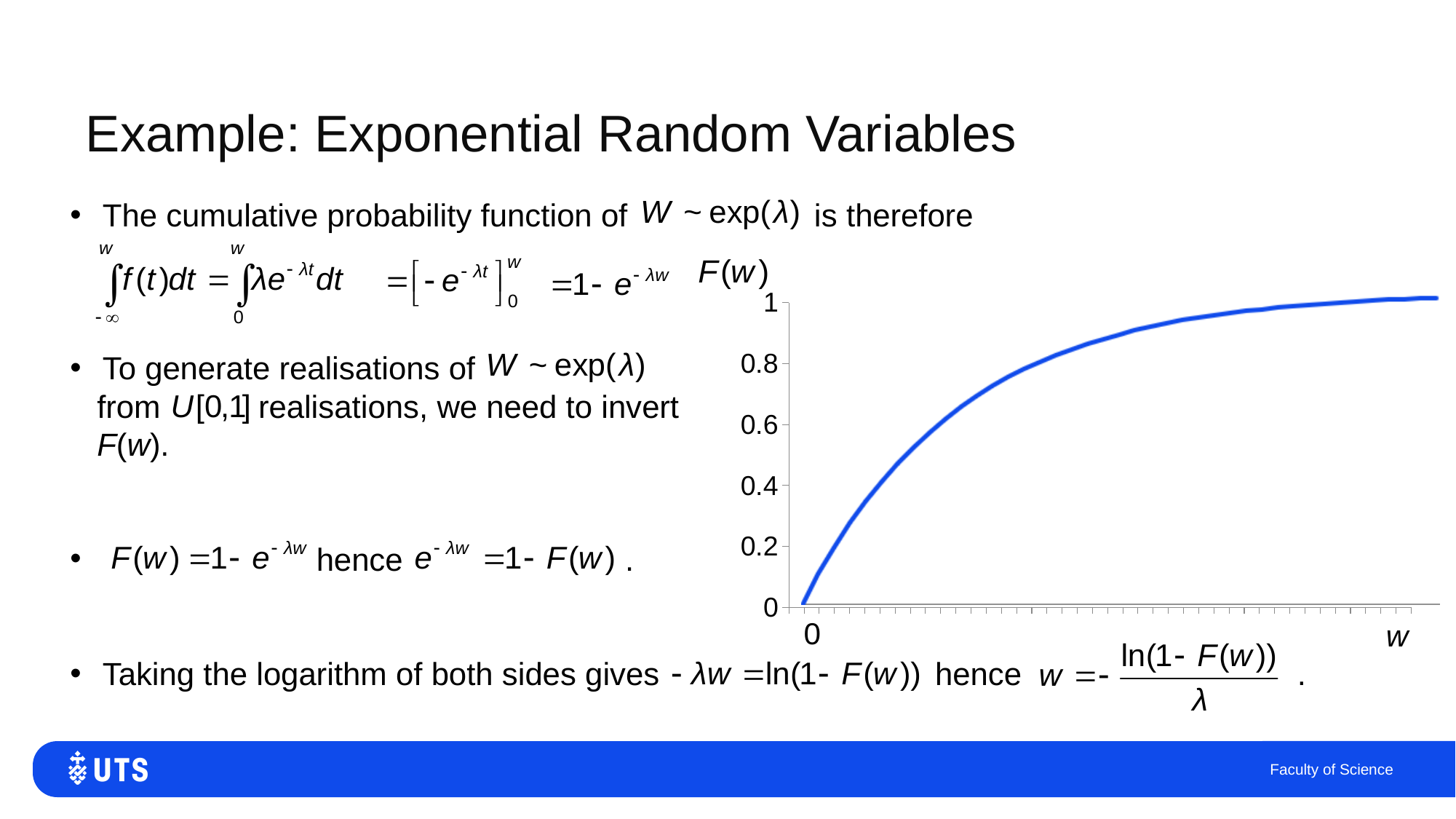
What is the label on the vertical axis of the chart? F(w) Is the value of the curve at the right-hand end of the horizontal axis greater or less than 0.8? greater How many lines are plotted on the chart? 1 Does the plotted curve rise or fall as w increases? rise What is the highest value labelled on the vertical axis? 1 What is the label on the horizontal axis of the chart? w What is the value of the curve at w = 0? 0 How many labelled tick values are shown on the vertical axis? 6 Is the value of the curve at the left-hand end of the horizontal axis greater or less than 0.2? less What kind of chart is shown on the slide? line chart